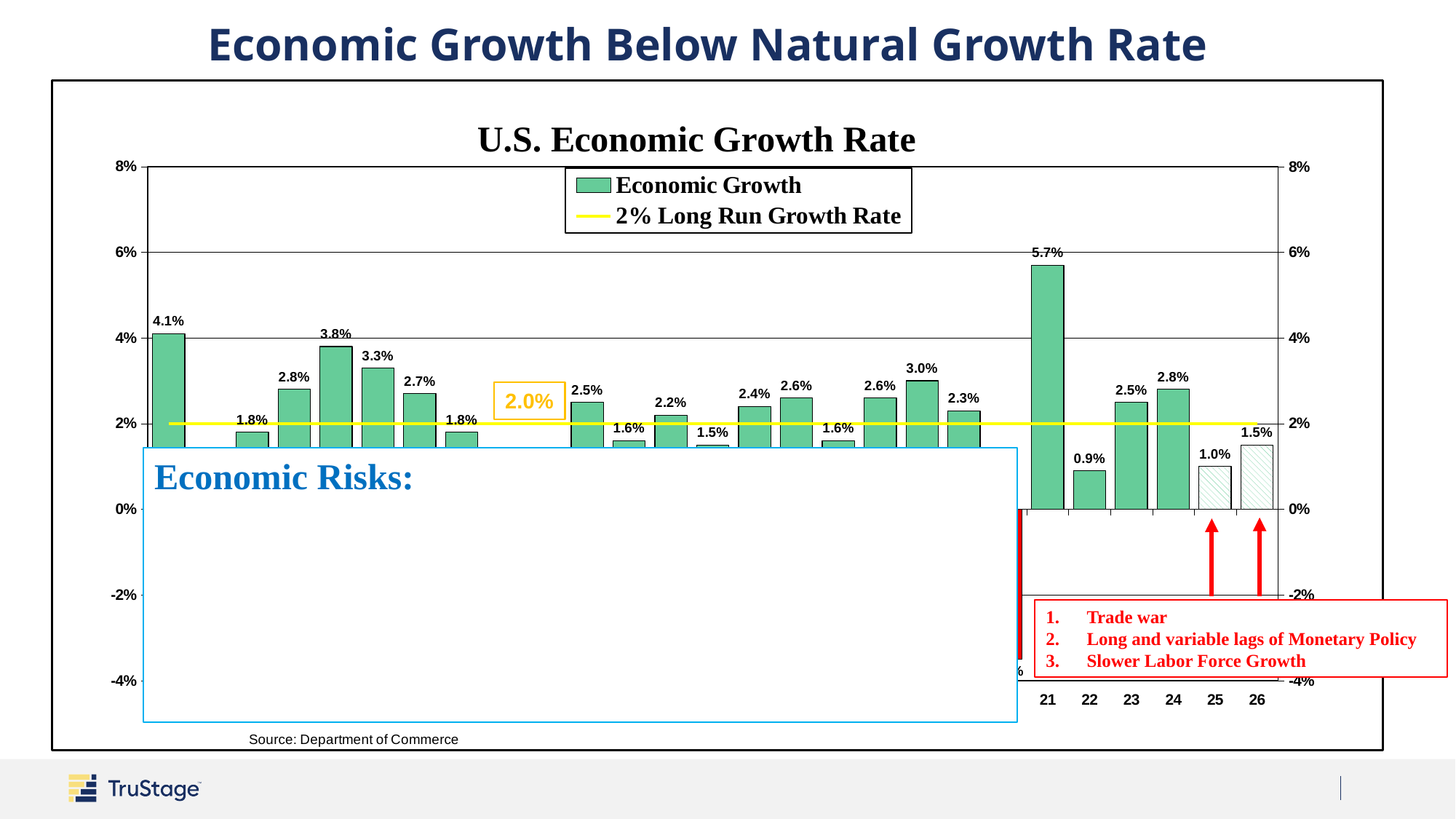
What is the title of the chart? U.S. Economic Growth Rate What is the difference in economic growth rate between year 24 and year 25? 1.8% Among years 21 through 26, which year has the lowest economic growth rate? 22 Which year has the highest economic growth rate on the chart? 21 Which year has a higher economic growth rate, 23 or 24? 24 Is the economic growth rate for year 21 greater or less than 4%? greater What is the economic growth rate for year 26? 1.5% What is the economic growth rate for year 21? 5.7% What is the economic growth rate for year 24? 2.8% What is the economic growth rate for year 22? 0.9% What kind of chart is used to show Economic Growth? bar chart How many series does the legend list? 2